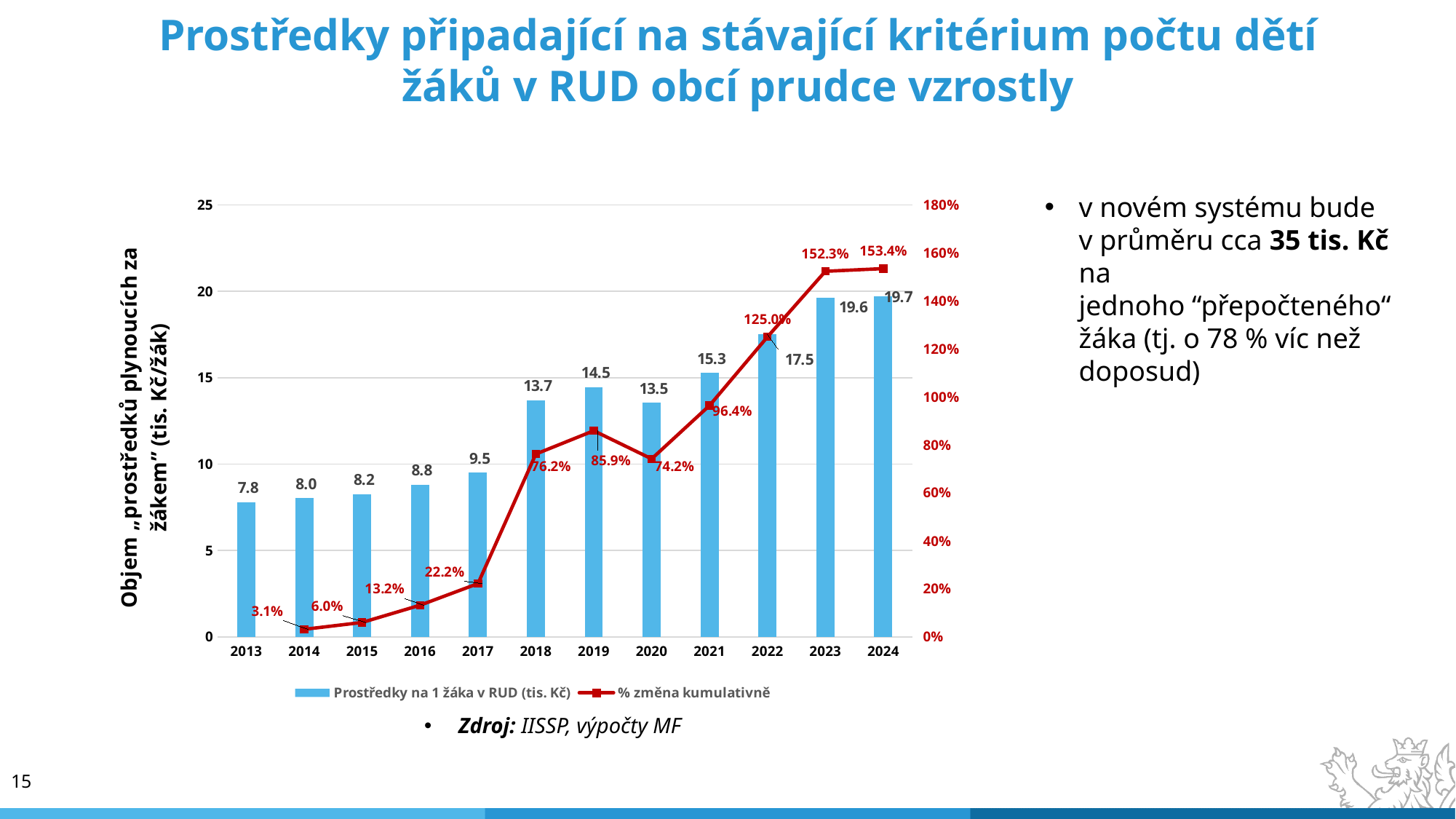
What is the % změna kumulativně value for 2022? 125.0% What is the % změna kumulativně value for 2020? 74.2% Which year has a larger Prostředky na 1 žáka v RUD value, 2019 or 2020? 2019 How many series does the chart legend list? 2 What is the difference between the Prostředky na 1 žáka v RUD values for 2024 and 2013? 11.9 Which year has the lowest value of Prostředky na 1 žáka v RUD (tis. Kč)? 2013 Which year has the highest % změna kumulativně value? 2024 Do the Prostředky na 1 žáka v RUD values generally rise or fall from 2013 to 2024? Rise What is the value of Prostředky na 1 žáka v RUD (tis. Kč) for 2018? 13.7 How many years are shown on the x axis of the chart? 12 Is the Prostředky na 1 žáka v RUD value for 2017 greater or less than 10? less What kind of chart is shown on the slide? Combination bar and line chart